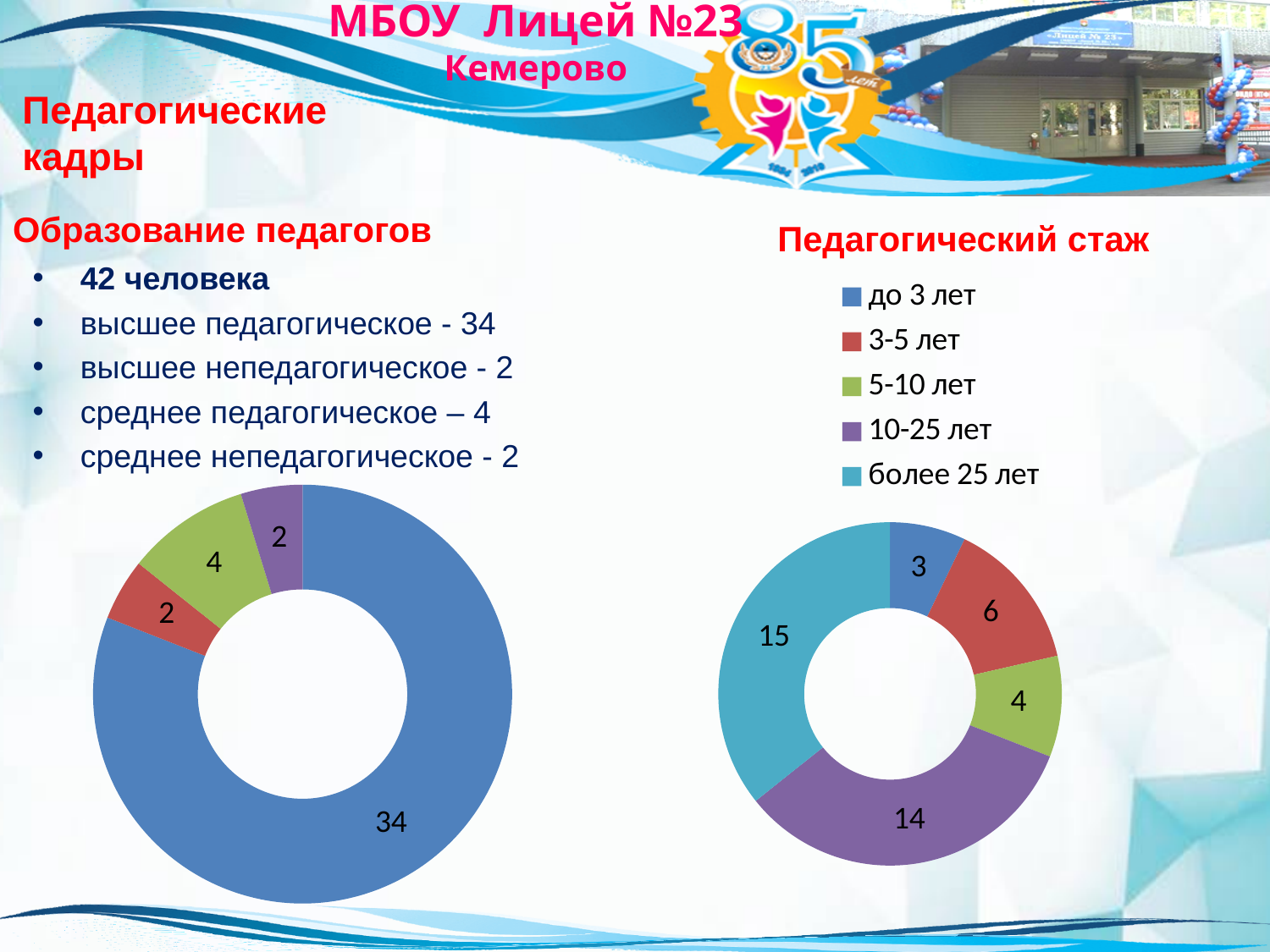
In the 'Педагогический стаж' chart, what is the value for 'более 25 лет'? 15 How many categories does the legend of the 'Педагогический стаж' chart list? 5 In the 'Педагогический стаж' chart, which category has the largest value? более 25 лет In the 'Образование педагогов' chart on the left, what is the value of the largest slice? 34 What kind of chart is the 'Педагогический стаж' chart? doughnut chart In the 'Педагогический стаж' chart, which is larger: '3-5 лет' or '5-10 лет'? 3-5 лет What is the total of all values in the 'Педагогический стаж' chart? 42 In the 'Педагогический стаж' chart, what is the difference between the values for 'более 25 лет' and 'до 3 лет'? 12 In the 'Педагогический стаж' chart, what is the value for '3-5 лет'? 6 In the 'Педагогический стаж' chart, what is the value for '10-25 лет'? 14 In the 'Педагогический стаж' chart, which category has the smallest value? до 3 лет How many slices does the 'Образование педагогов' chart on the left have? 4